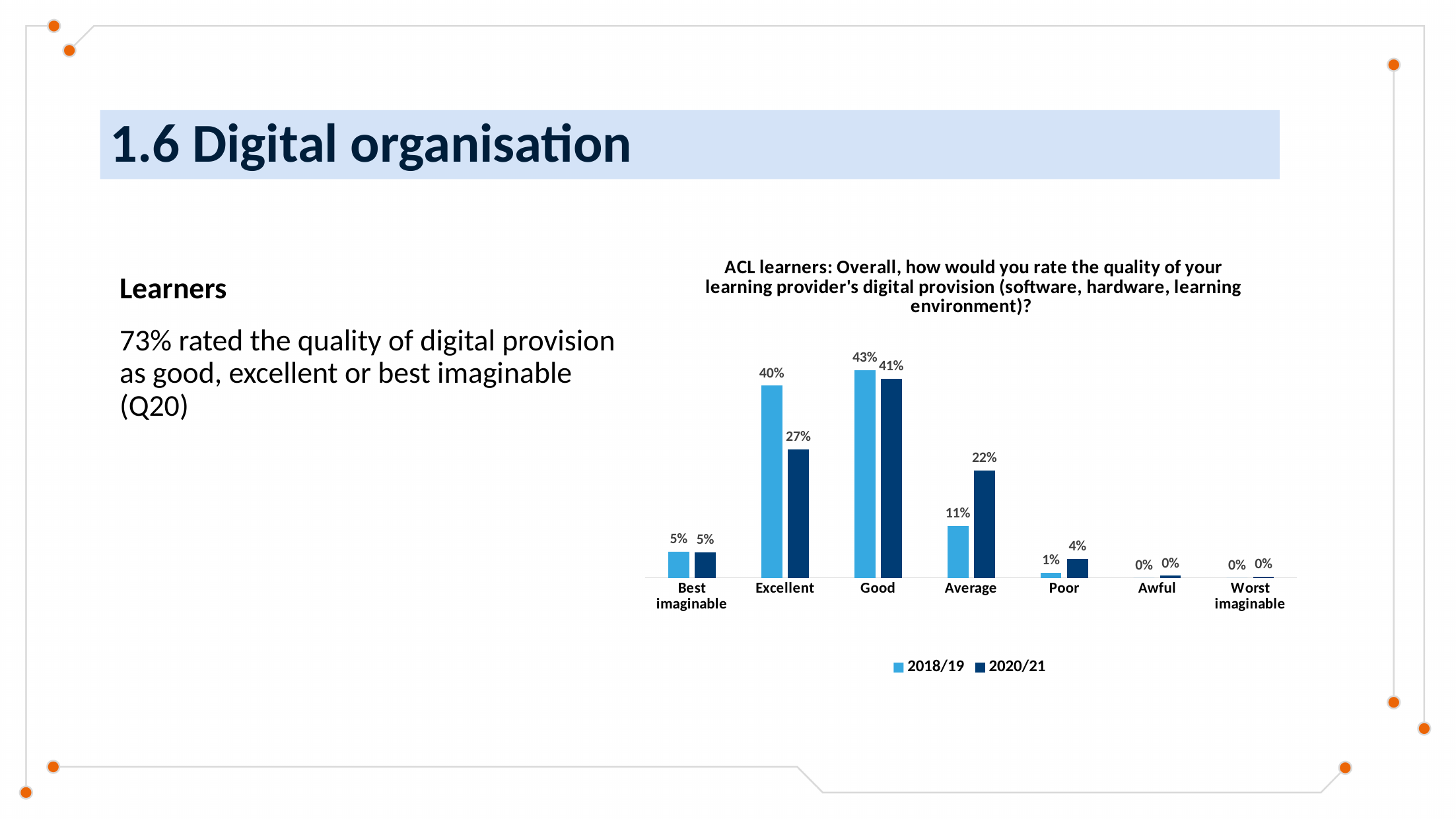
What percentage of ACL learners rated their provider's digital provision as Average in 2020/21? 22% What type of chart is shown on the slide? Bar chart Which category has the highest value for the 2020/21 series? Good What is the difference between the 2018/19 and 2020/21 values for Excellent? 13 percentage points How many rating categories are shown on the x axis of the chart? 7 How many series does the chart legend list? 2 Which series is shown in the darker blue colour in the chart? 2020/21 Which category has the highest value for the 2018/19 series? Good What percentage of ACL learners rated their provider's digital provision as Excellent in 2018/19? 40% Which is larger for the Good category: the 2018/19 value or the 2020/21 value? 2018/19 What is the 2020/21 value for the Poor category? 4% What is the difference between the 2020/21 and 2018/19 values for Average? 11 percentage points